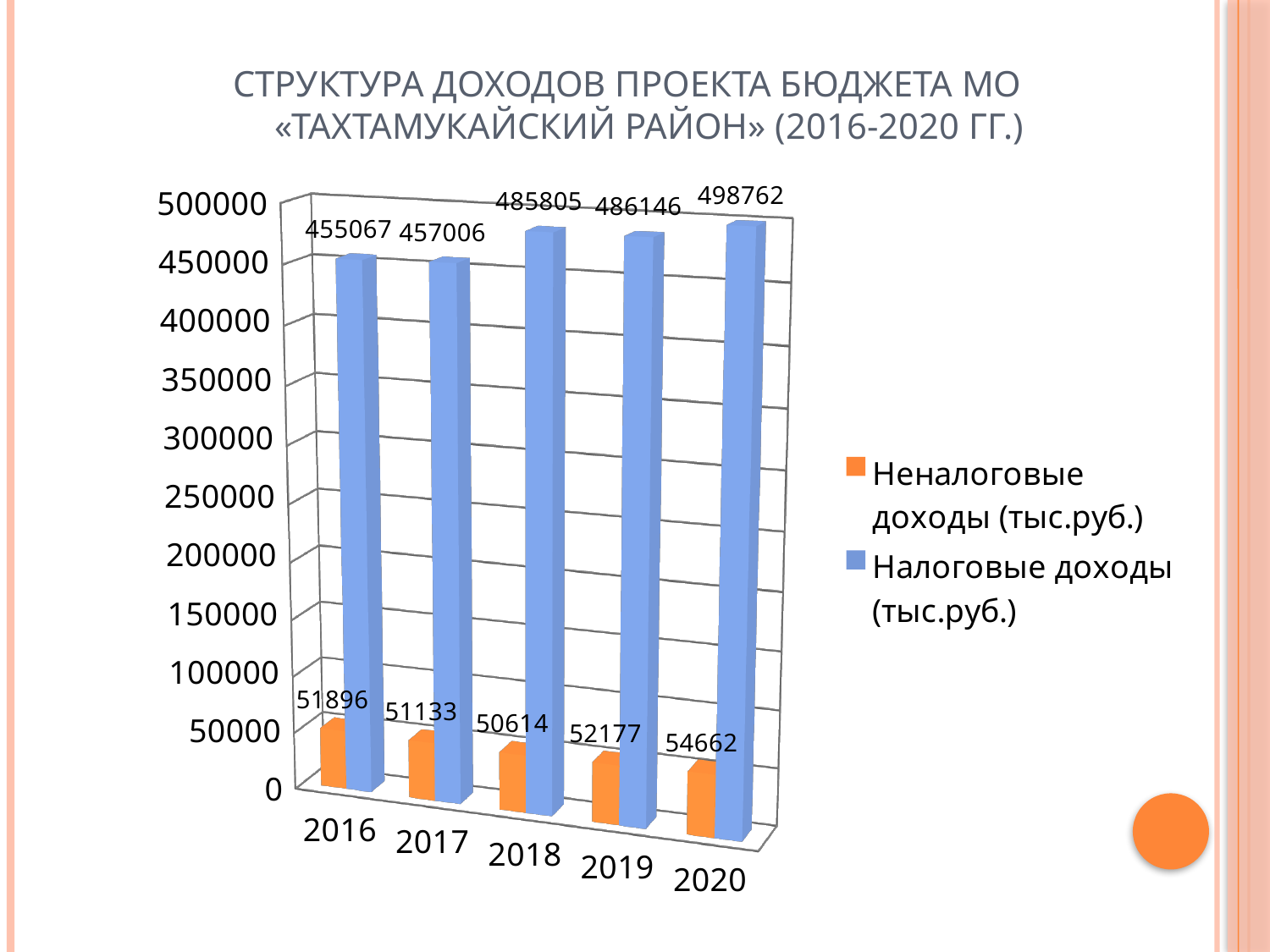
Which is larger: Неналоговые доходы (тыс.руб.) in 2019 or in 2017? 2019 How many years are shown on the x axis? 5 In which year is Неналоговые доходы (тыс.руб.) lowest? 2018 What is the value of Неналоговые доходы (тыс.руб.) for 2016? 51896 What is the value of Неналоговые доходы (тыс.руб.) for 2020? 54662 What kind of chart is shown on the slide? bar chart Is the value of Налоговые доходы (тыс.руб.) for 2017 greater or less than 450000? greater What is the value of Налоговые доходы (тыс.руб.) for 2018? 485805 In which year is Налоговые доходы (тыс.руб.) highest? 2020 How many series does the legend list? 2 What is the difference between Налоговые доходы (тыс.руб.) in 2020 and in 2016? 43695 Which colour represents Налоговые доходы (тыс.руб.) in the chart? blue